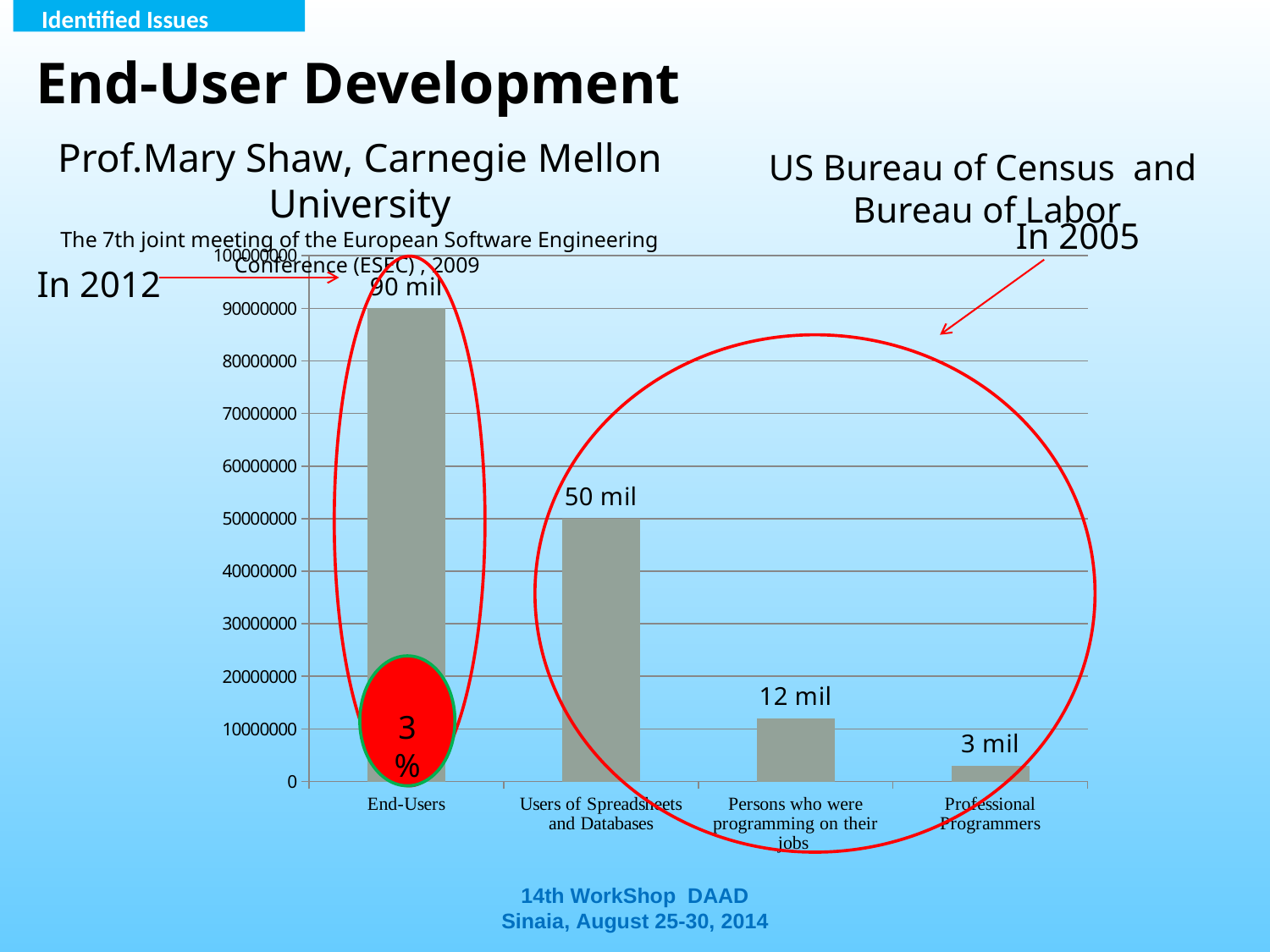
What value is labelled on the Users of Spreadsheets and Databases bar? 50 mil How many categories are shown on the x axis of the chart? 4 What value is labelled on the bar for Persons who were programming on their jobs? 12 mil What value is labelled on the Professional Programmers bar? 3 mil What is the difference between the End-Users value and the Users of Spreadsheets and Databases value? 40 mil Which is larger, the value for Users of Spreadsheets and Databases or the value for Persons who were programming on their jobs? Users of Spreadsheets and Databases What kind of chart is shown on the slide? bar chart What value is labelled on the End-Users bar? 90 mil What is the difference between the value for Persons who were programming on their jobs and the value for Professional Programmers? 9 mil Is the value for Persons who were programming on their jobs greater or less than 20000000? less Which category has the lowest bar? Professional Programmers Which category has the highest bar? End-Users